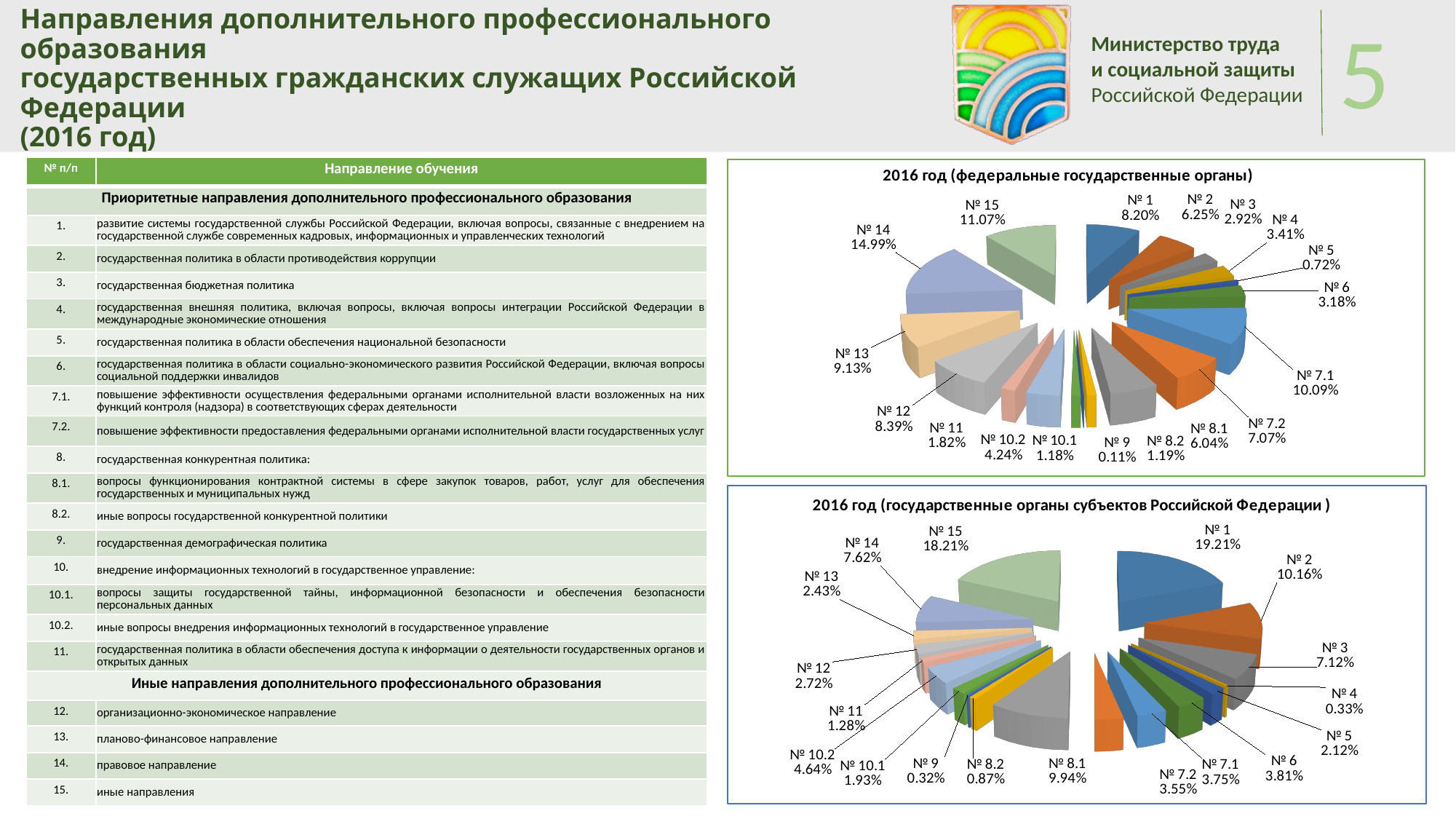
In the chart titled "2016 год (государственные органы субъектов Российской Федерации)", what is the share for № 1? 19.21% In the chart titled "2016 год (государственные органы субъектов Российской Федерации)", which category has the largest share? № 1 In the chart titled "2016 год (государственные органы субъектов Российской Федерации)", what is the difference in percentage points between № 1 and № 15? 1.00 In the chart titled "2016 год (федеральные государственные органы)", what is the difference in percentage points between № 14 and № 15? 3.92 In the chart titled "2016 год (федеральные государственные органы)", what is the share for № 14? 14.99% In the chart titled "2016 год (государственные органы субъектов Российской Федерации)", what is the share for № 8.1? 9.94% In the chart titled "2016 год (государственные органы субъектов Российской Федерации)", which is larger, the share for № 2 or the share for № 14? № 2 In the chart titled "2016 год (федеральные государственные органы)", which category has the smallest share? № 9 In the chart titled "2016 год (федеральные государственные органы)", how many slices does the pie have? 18 In the chart titled "2016 год (федеральные государственные органы)", which category has the largest share? № 14 What type of chart is the lower chart on the slide? Pie chart In the chart titled "2016 год (федеральные государственные органы)", what is the share for № 7.1? 10.09%